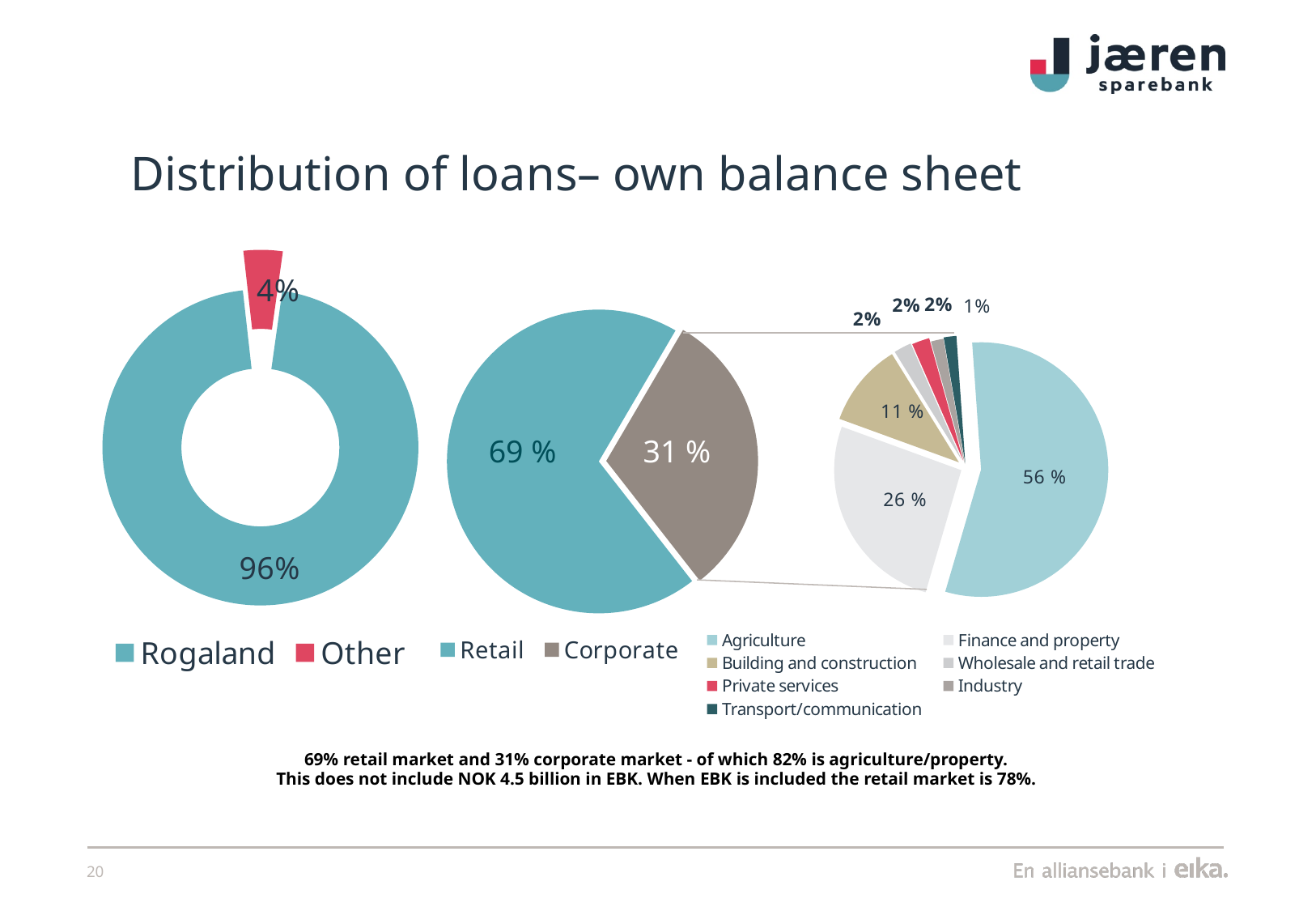
In the middle pie chart, what is the value for Corporate? 31 % In the middle pie chart, what is the difference between the Retail and Corporate shares? 38 % What type of chart is the left chart showing Rogaland and Other? Donut chart In the middle pie chart, what is the value for Retail? 69 % In the right-hand breakdown pie chart, which category has the smallest share? Transport/communication In the left donut chart, what share of loans is labelled Other? 4% In the left donut chart, what share of loans is in Rogaland? 96% In the right-hand breakdown pie chart, what is the value for Building and construction? 11 % How many categories does the legend of the right-hand breakdown pie chart list? 7 In the right-hand breakdown pie chart, what is the value for Agriculture? 56 % In the right-hand breakdown pie chart, what is the value for Finance and property? 26 % In the right-hand breakdown pie chart, which category has the largest share? Agriculture